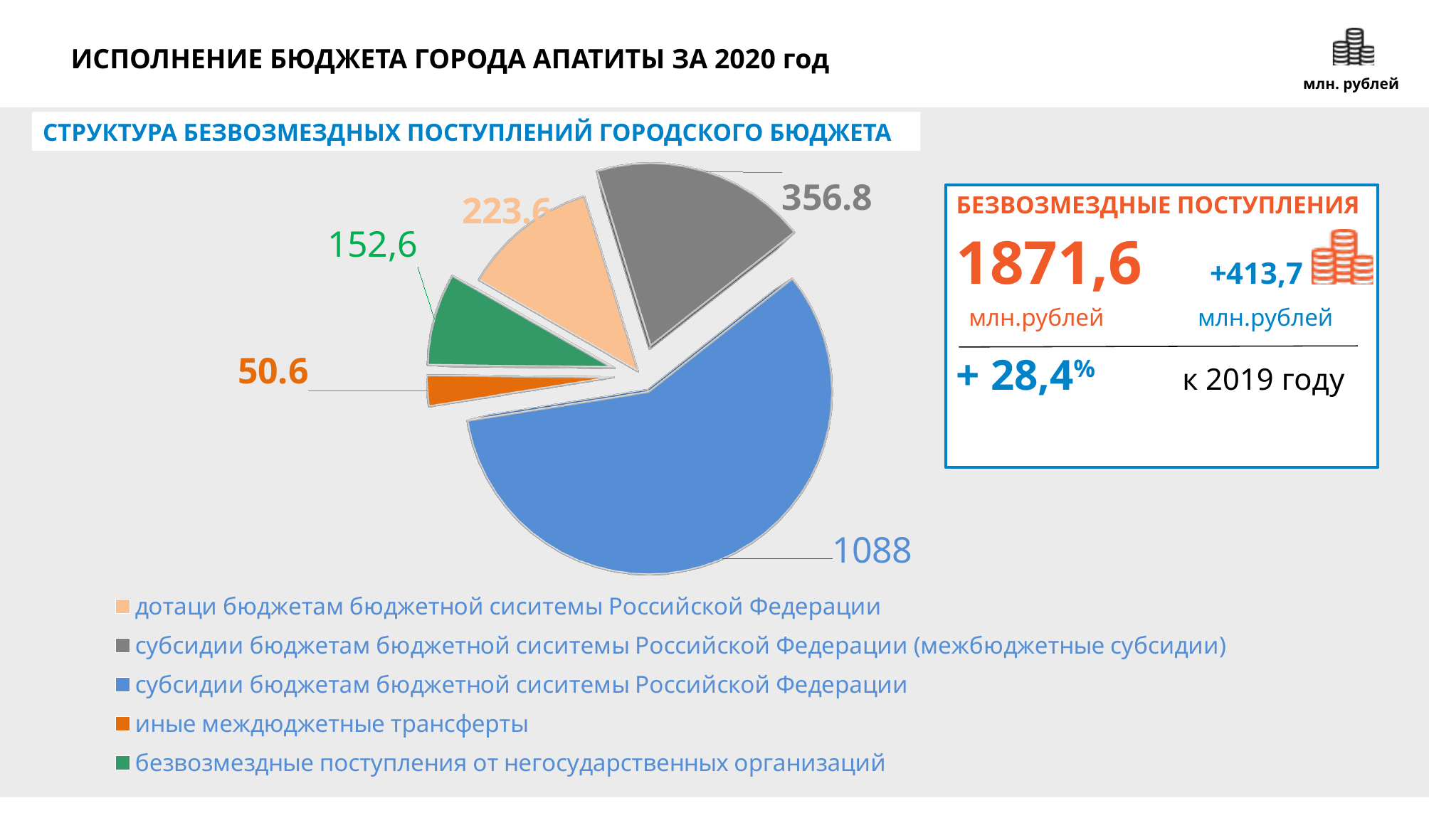
Which is larger: the slice for 'дотаци бюджетам бюджетной сиситемы Российской Федерации' or the slice for 'безвозмездные поступления от негосударственных организаций'? дотаци бюджетам бюджетной сиситемы Российской Федерации What type of chart is shown on the slide? pie chart What is the value of the slice for 'иные междюджетные трансферты'? 50.6 What is the value of the slice for 'субсидии бюджетам бюджетной сиситемы Российской Федерации (межбюджетные субсидии)'? 356.8 What is the value of the slice for 'дотаци бюджетам бюджетной сиситемы Российской Федерации'? 223.6 What is the value of the slice for 'безвозмездные поступления от негосударственных организаций'? 152,6 What is the title of the pie chart section on the slide? СТРУКТУРА БЕЗВОЗМЕЗДНЫХ ПОСТУПЛЕНИЙ ГОРОДСКОГО БЮДЖЕТА What is the difference between the largest slice (1088) and the slice labelled 356.8? 731.2 Which category has the largest slice in the pie chart? субсидии бюджетам бюджетной сиситемы Российской Федерации Which category has the smallest slice in the pie chart? иные междюджетные трансферты What colour is the slice representing 'иные междюджетные трансферты'? orange How many slices does the pie chart have? 5